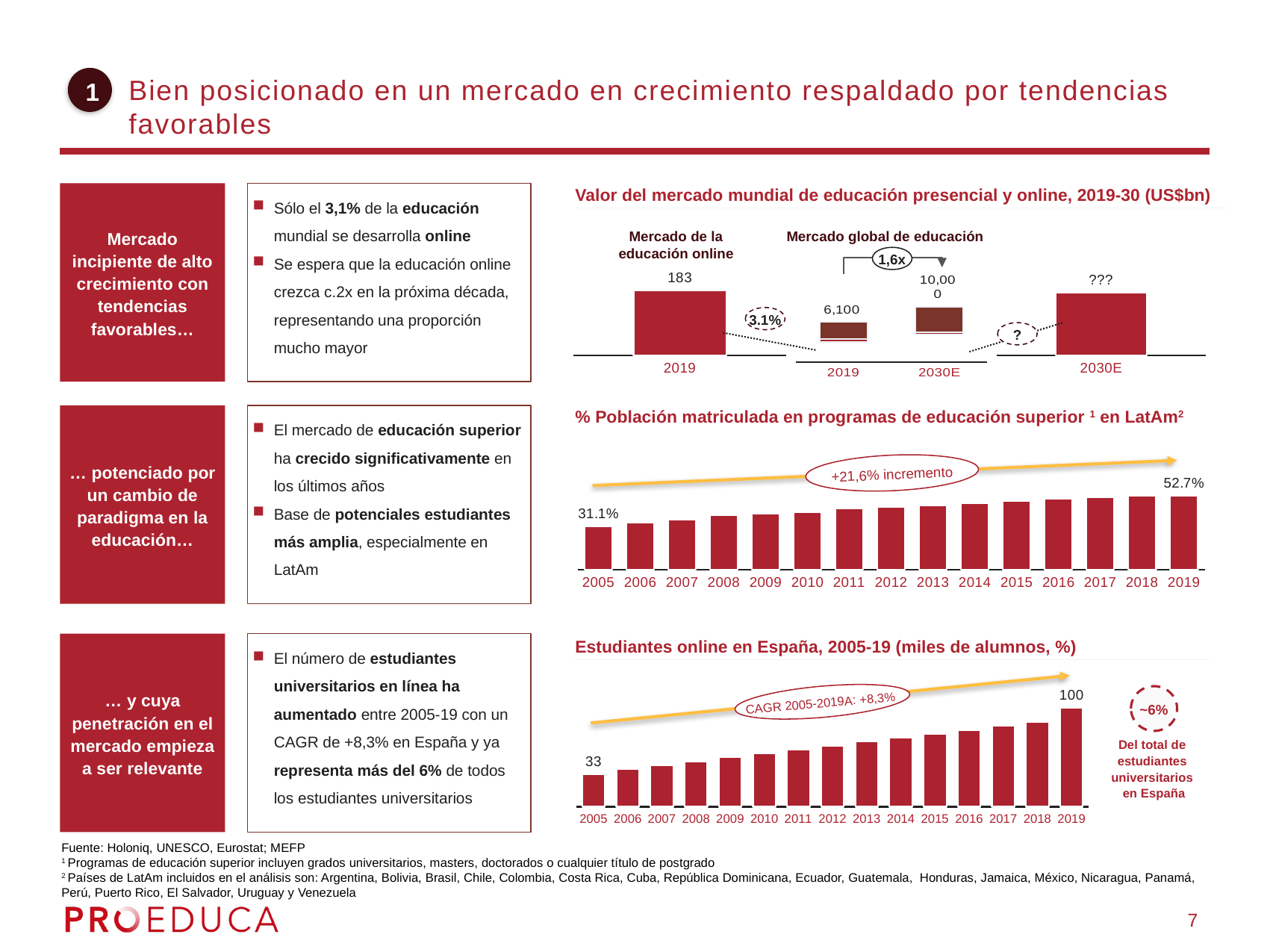
In the chart 'Valor del mercado mundial de educación presencial y online, 2019-30', what is the value of the online education market in 2019? 183 In the chart '% Población matriculada en programas de educación superior en LatAm', what is the value for 2019? 52.7% In the chart 'Estudiantes online en España, 2005-19', which year has the highest value? 2019 In the chart '% Población matriculada en programas de educación superior en LatAm', what is the difference between the 2019 and 2005 values? 21.6% In the chart '% Población matriculada en programas de educación superior en LatAm', do the values rise or fall from 2005 to 2019? rise In the chart 'Estudiantes online en España, 2005-19', what is the difference between the 2019 and 2005 values? 67 In the chart '% Población matriculada en programas de educación superior en LatAm', how many years are plotted? 15 In the chart 'Estudiantes online en España, 2005-19', what is the value for 2005? 33 In the chart 'Estudiantes online en España, 2005-19', what is the value for 2019? 100 What kind of chart is 'Estudiantes online en España, 2005-19'? bar chart In the chart '% Población matriculada en programas de educación superior en LatAm', what is the value for 2005? 31.1% In the chart 'Valor del mercado mundial de educación presencial y online, 2019-30', what is the value of the global education market in 2019? 6,100